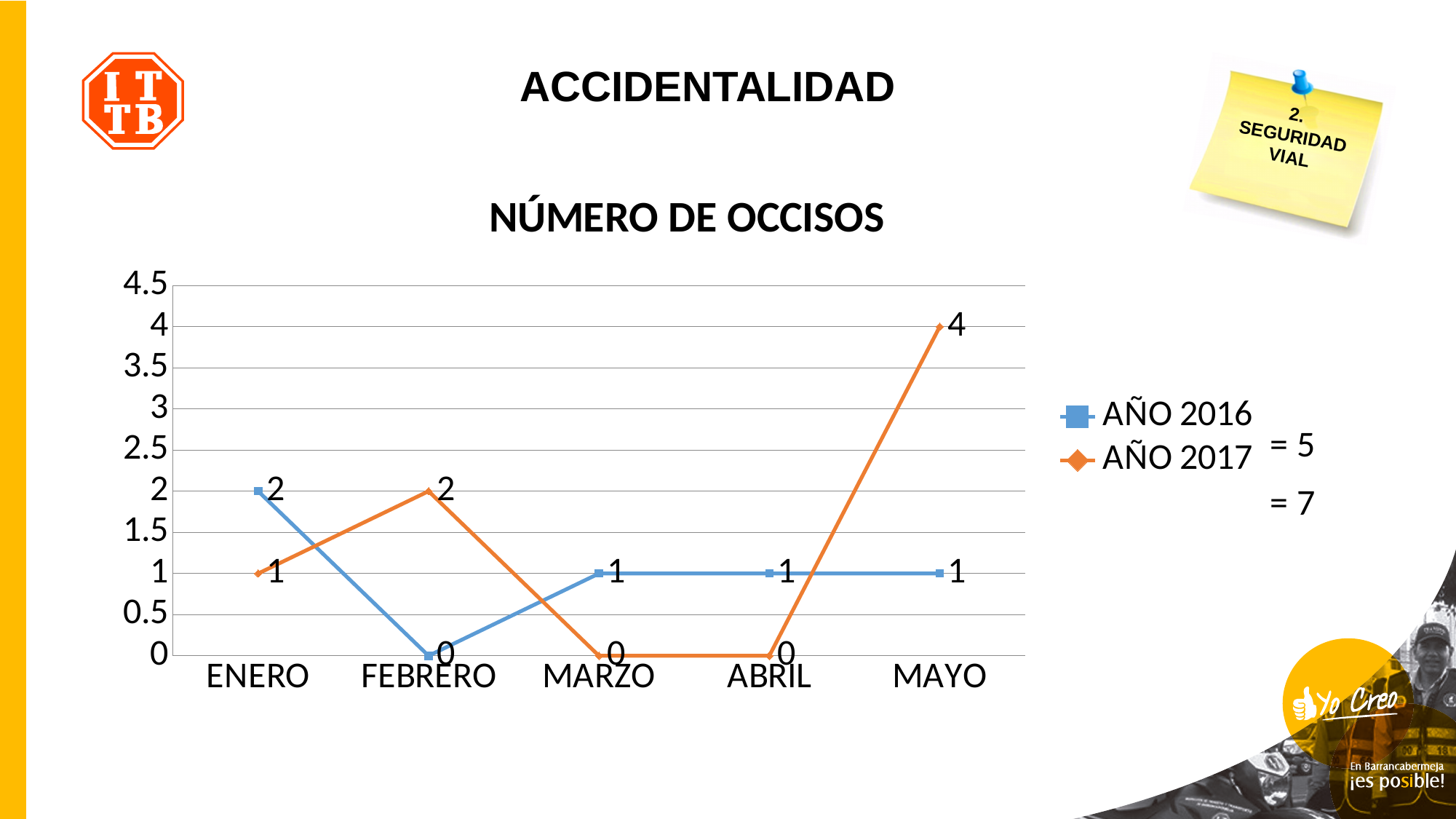
What is the value for AÑO 2017 in MAYO? 4 Which colour is used for the AÑO 2017 series? orange How many months are shown on the x axis? 5 What is the value for AÑO 2017 in FEBRERO? 2 What is the value for AÑO 2016 in FEBRERO? 0 In which month does AÑO 2017 reach its highest value? MAYO In ENERO, which series has the larger value, AÑO 2016 or AÑO 2017? AÑO 2016 In which month does AÑO 2016 have its lowest value? FEBRERO What is the difference between AÑO 2017 and AÑO 2016 in MAYO? 3 What is the value for AÑO 2016 in ENERO? 2 What type of chart is shown under the title NÚMERO DE OCCISOS? line chart How many series does the legend list? 2